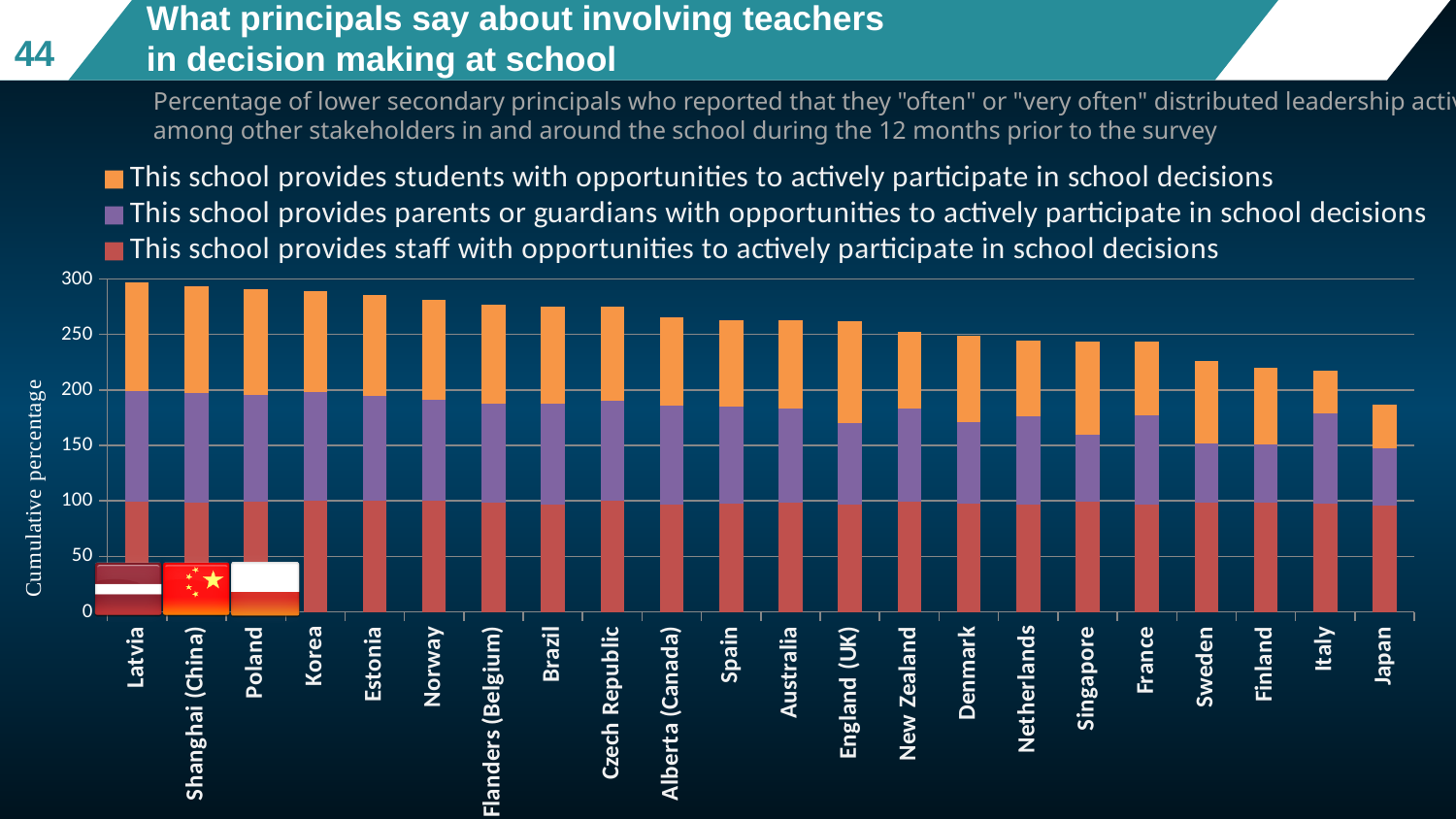
Is the cumulative percentage for Japan greater or less than 200? less Is the cumulative percentage for Latvia greater or less than 250? greater How many countries or regions are shown along the x axis? 22 Do the cumulative percentages rise or fall from left to right along the x axis? Fall Which country or region has the lowest cumulative percentage? Japan Is the cumulative percentage for Sweden greater or less than 250? less Which has a larger cumulative percentage, Korea or Sweden? Korea What is the label on the y axis? Cumulative percentage Which country or region has the highest cumulative percentage? Latvia What kind of chart is shown on the slide? Stacked bar chart Which series is shown in orange in the legend? This school provides students with opportunities to actively participate in school decisions How many series does the legend list? 3